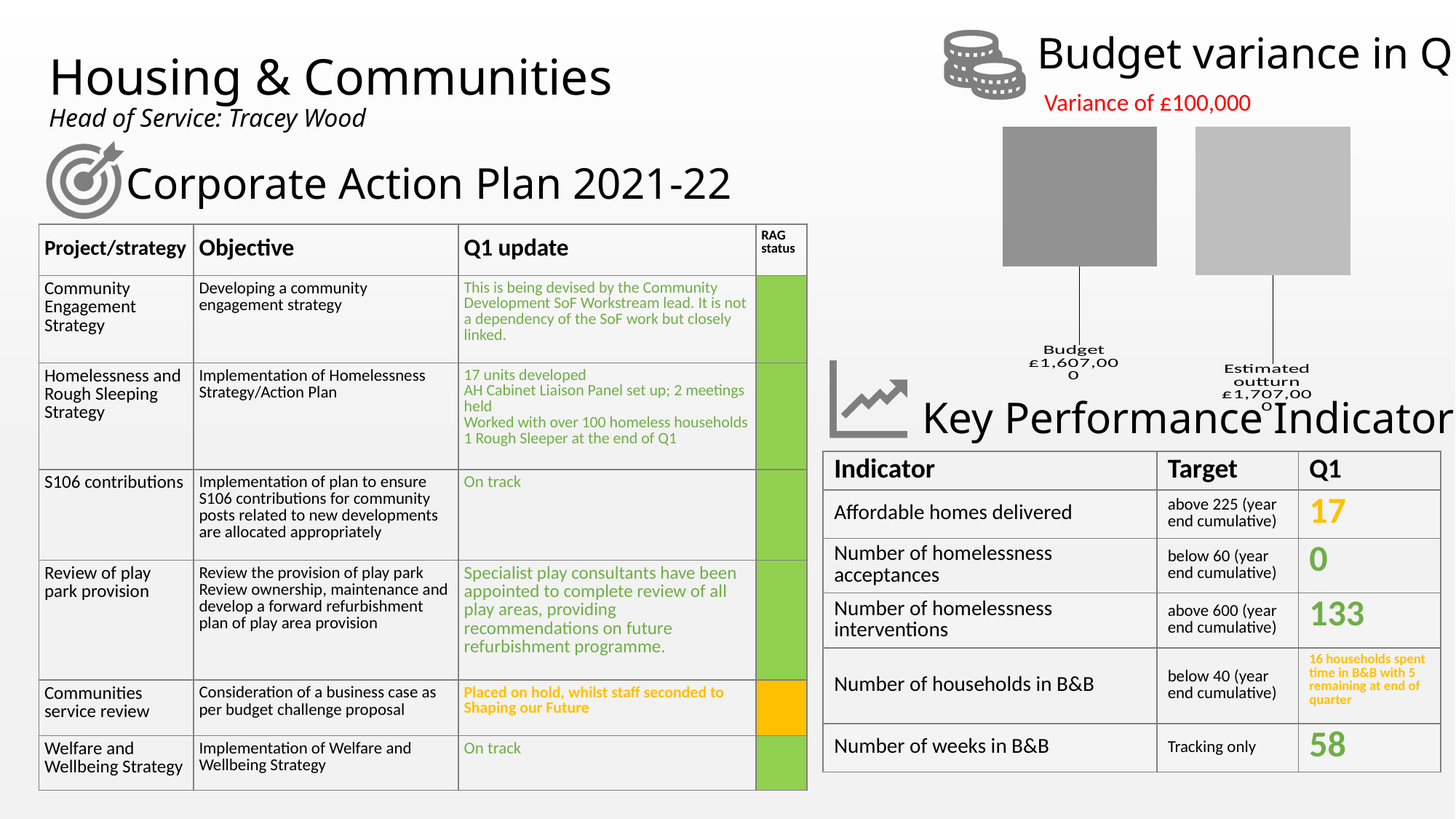
In the budget variance chart, what is the difference between the Estimated outturn and the Budget? £100,000 In the budget variance chart, which bar is the darker grey: Budget or Estimated outturn? Budget What variance amount is stated in red above the budget variance chart? Variance of £100,000 How many bars does the budget variance chart show? 2 In the budget variance chart, which bar is the highest? Estimated outturn In the budget variance chart, what is the value of the Estimated outturn bar? £1,707,000 In the budget variance chart, which bar is the lowest? Budget In the budget variance chart, which is larger: the Budget or the Estimated outturn? Estimated outturn In the budget variance chart, what is the value of the Budget bar? £1,607,000 What kind of chart is the budget variance chart on the slide? bar chart Do the values in the budget variance chart rise or fall from the Budget bar to the Estimated outturn bar? rise